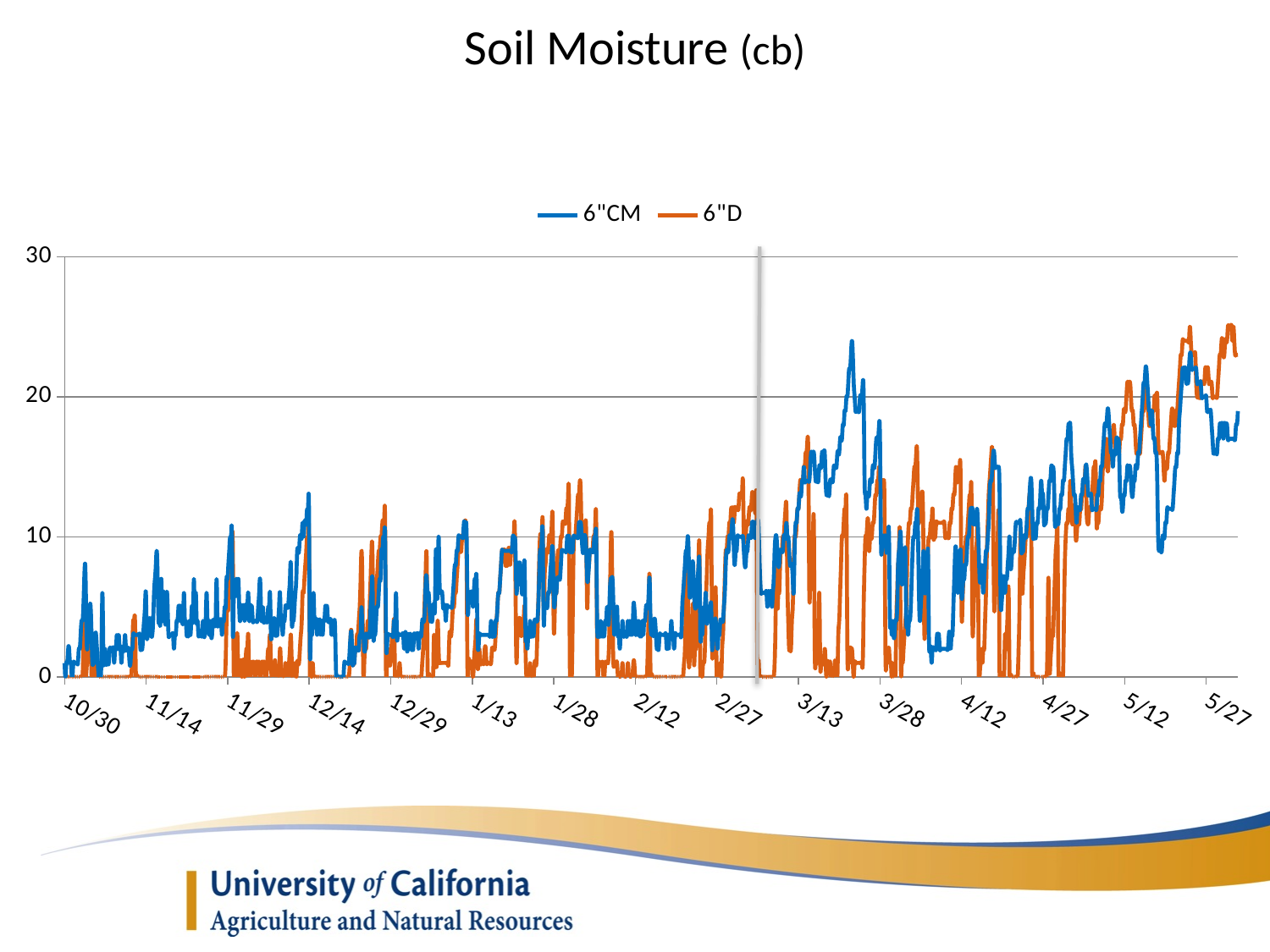
Is the highest value reached by either series greater or less than 30? less How many series does the legend list? 2 Around 5/27, which series has the higher value, 6"CM or 6"D? 6"D How many date labels are shown on the x axis? 15 What is the title of the chart? Soil Moisture (cb) Is the highest value reached by the 6"CM series greater or less than 20? greater What are the two series named in the legend? 6"CM and 6"D Is the value of the 6"D series at 11/14 greater or less than 10? less What kind of chart is shown on the slide? line chart Overall, do the soil moisture values rise or fall from 10/30 to 5/27? rise Around 10/30, which series has the higher value, 6"CM or 6"D? 6"CM